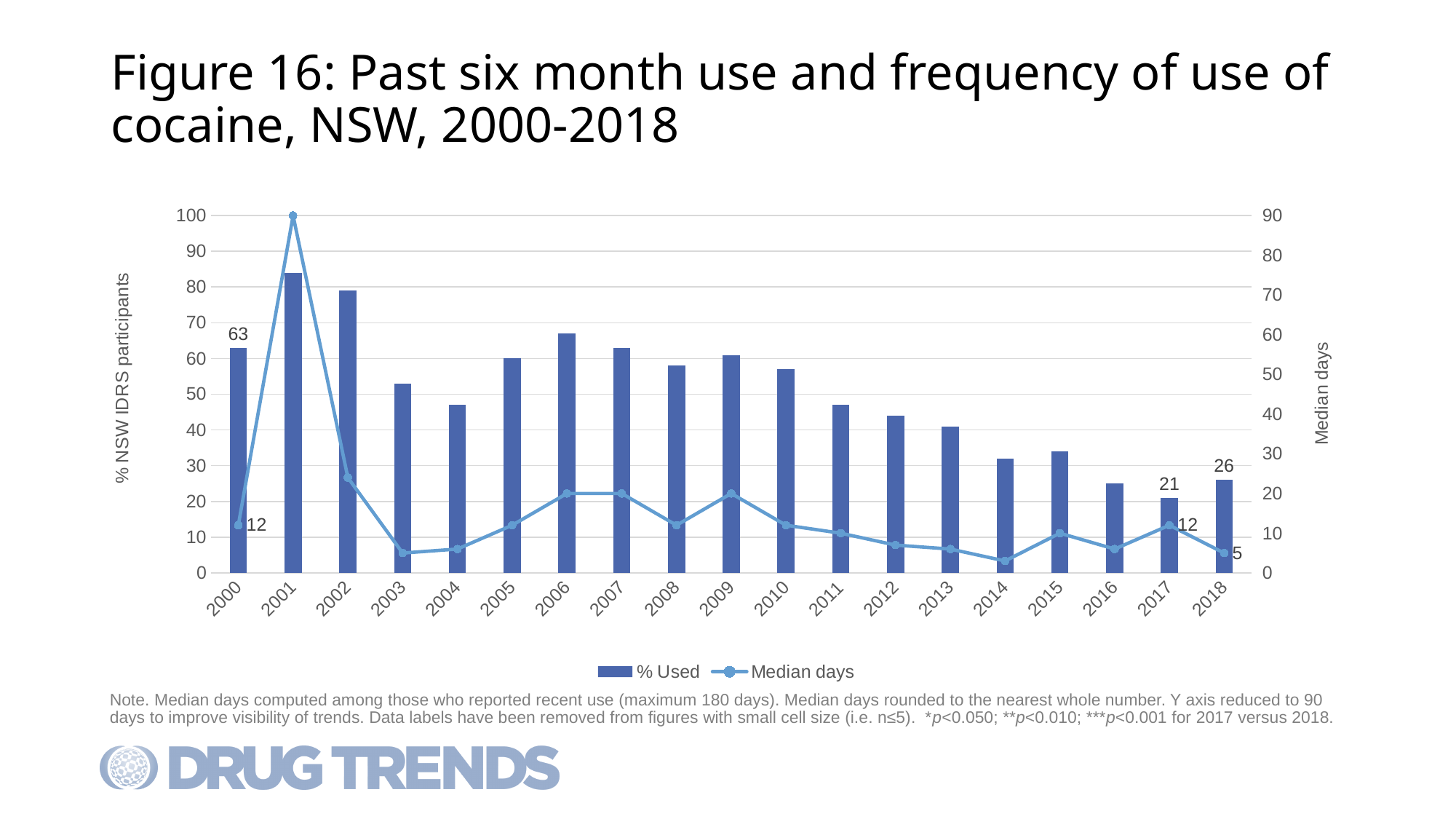
By how much did % Used change from 2017 to 2018? 5 Which year has the highest Median days? 2001 What is the difference in Median days between 2017 and 2018? 7 What is the Median days value for 2018? 5 What is the % Used value for 2017? 21 Which year has the highest % Used? 2001 What is the Median days value for 2000? 12 Which year has the lowest % Used? 2017 Is the % Used value for 2001 greater or less than 80? greater How many years are shown on the x axis? 19 How many series does the legend list? 2 What is the % Used value for 2000? 63